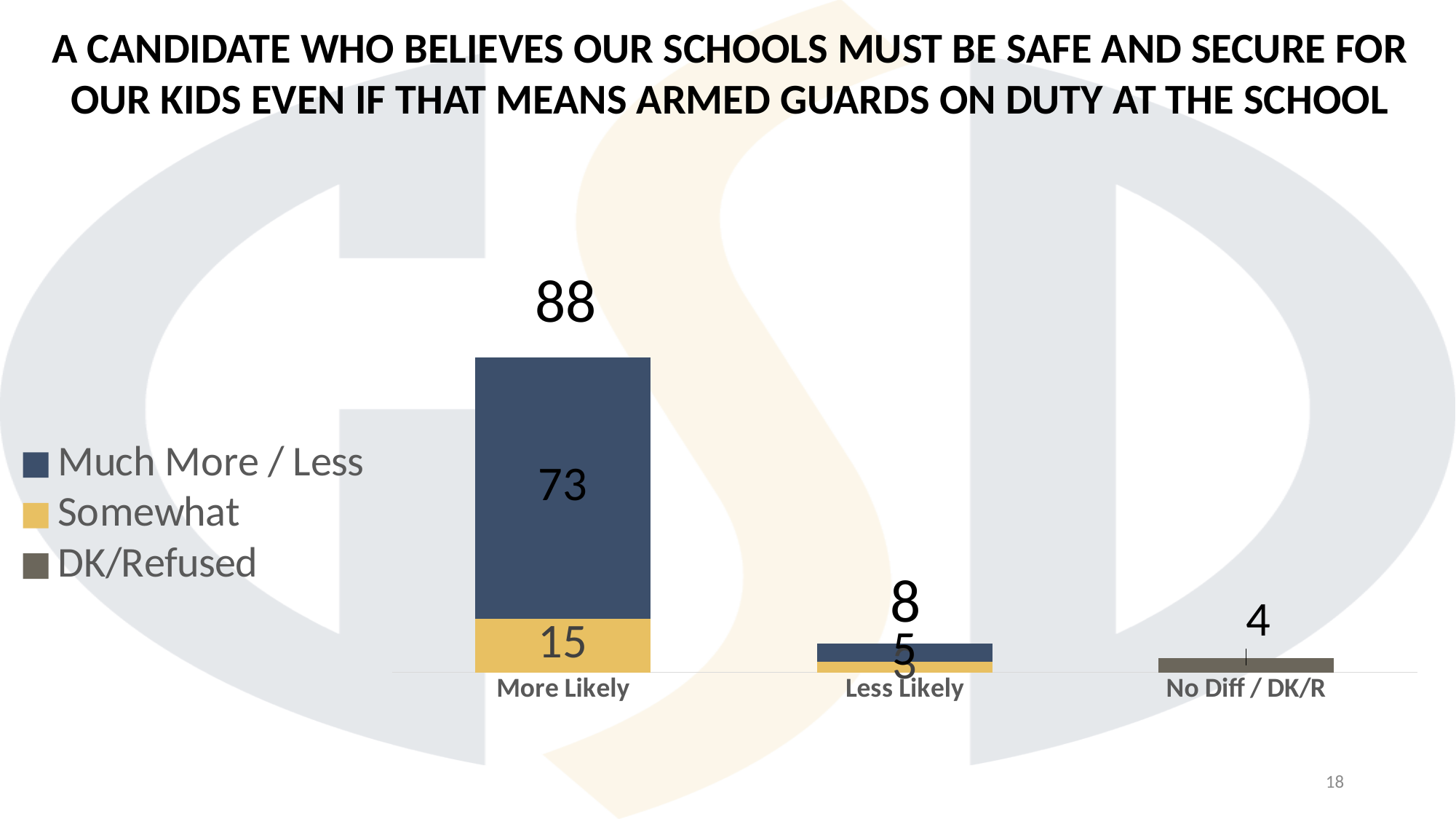
What is the difference between the More Likely total and the Less Likely total? 80 What kind of chart is shown on the slide? Stacked bar chart How many categories are shown on the x axis? 3 What is the Much More / Less value for the More Likely bar? 73 Which category has the highest total? More Likely What is the Somewhat value for the Less Likely bar? 3 Which category has the lowest total? No Diff / DK/R What is the total shown above the More Likely bar? 88 What is the value for No Diff / DK/R? 4 How many series does the legend list? 3 What is the total shown above the Less Likely bar? 8 What is the Somewhat value for the More Likely bar? 15